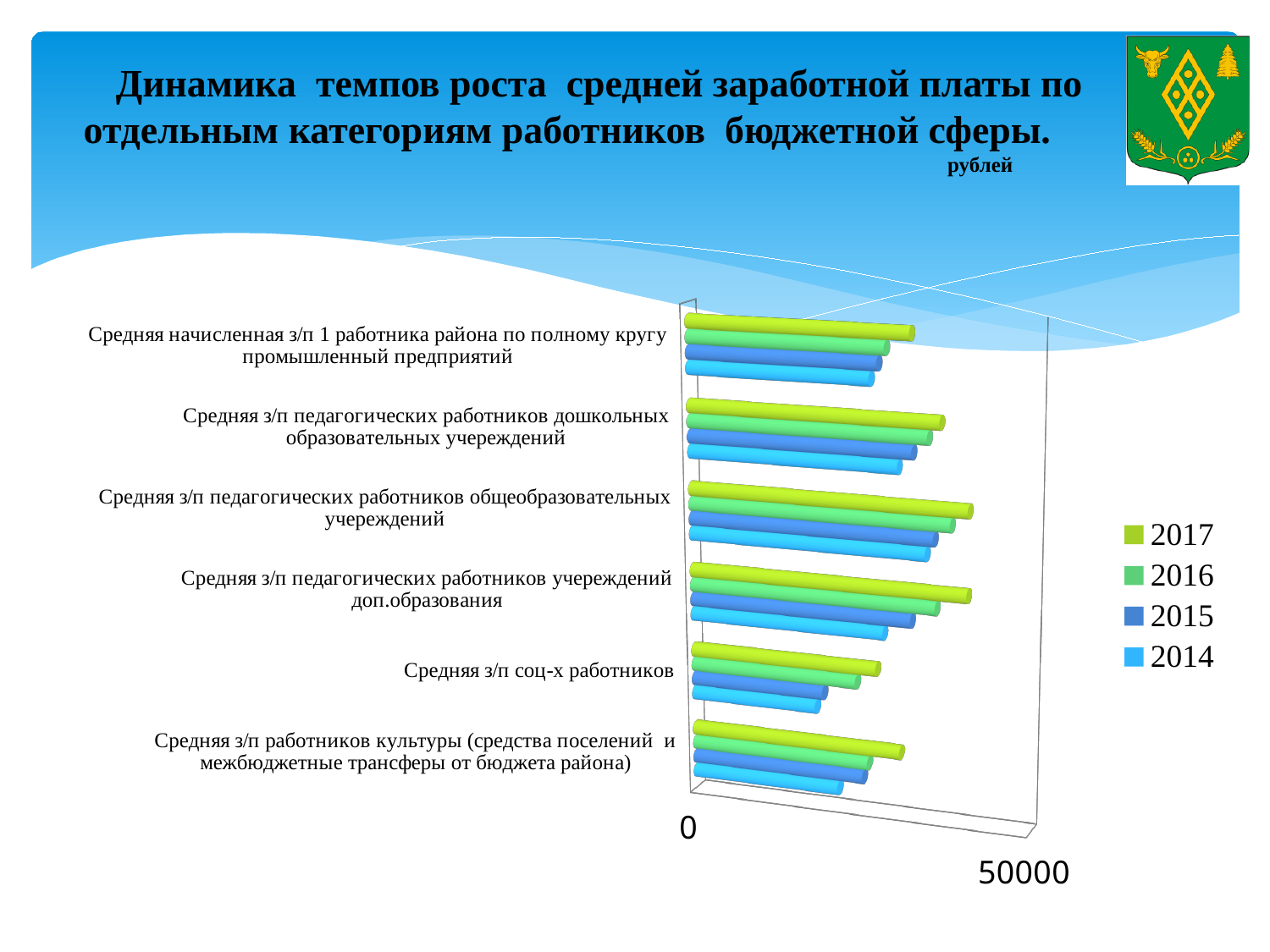
What unit is indicated for the chart values under the title? рублей What kind of chart is shown on the slide? bar chart Is the 2017 value for "Средняя з/п соц-х работников" greater or less than 50000? less Which category has the larger 2014 value: "Средняя з/п педагогических работников дошкольных образовательных учереждений" or "Средняя з/п соц-х работников"? Средняя з/п педагогических работников дошкольных образовательных учереждений Which years are listed in the chart legend? 2017, 2016, 2015, 2014 Within each category, do the values rise or fall from 2014 to 2017? rise For "Средняя з/п педагогических работников дошкольных образовательных учереждений", which year has the larger value: 2017 or 2014? 2017 Is the 2014 value for "Средняя з/п педагогических работников общеобразовательных учереждений" greater or less than 50000? less How many series does the chart legend list? 4 How many categories of workers are plotted on the chart? 6 Which category has the larger 2017 value: "Средняя з/п педагогических работников общеобразовательных учереждений" or "Средняя з/п соц-х работников"? Средняя з/п педагогических работников общеобразовательных учереждений Which series has the lowest value for "Средняя з/п работников культуры (средства поселений и межбюджетные трансферы от бюджета района)"? 2014